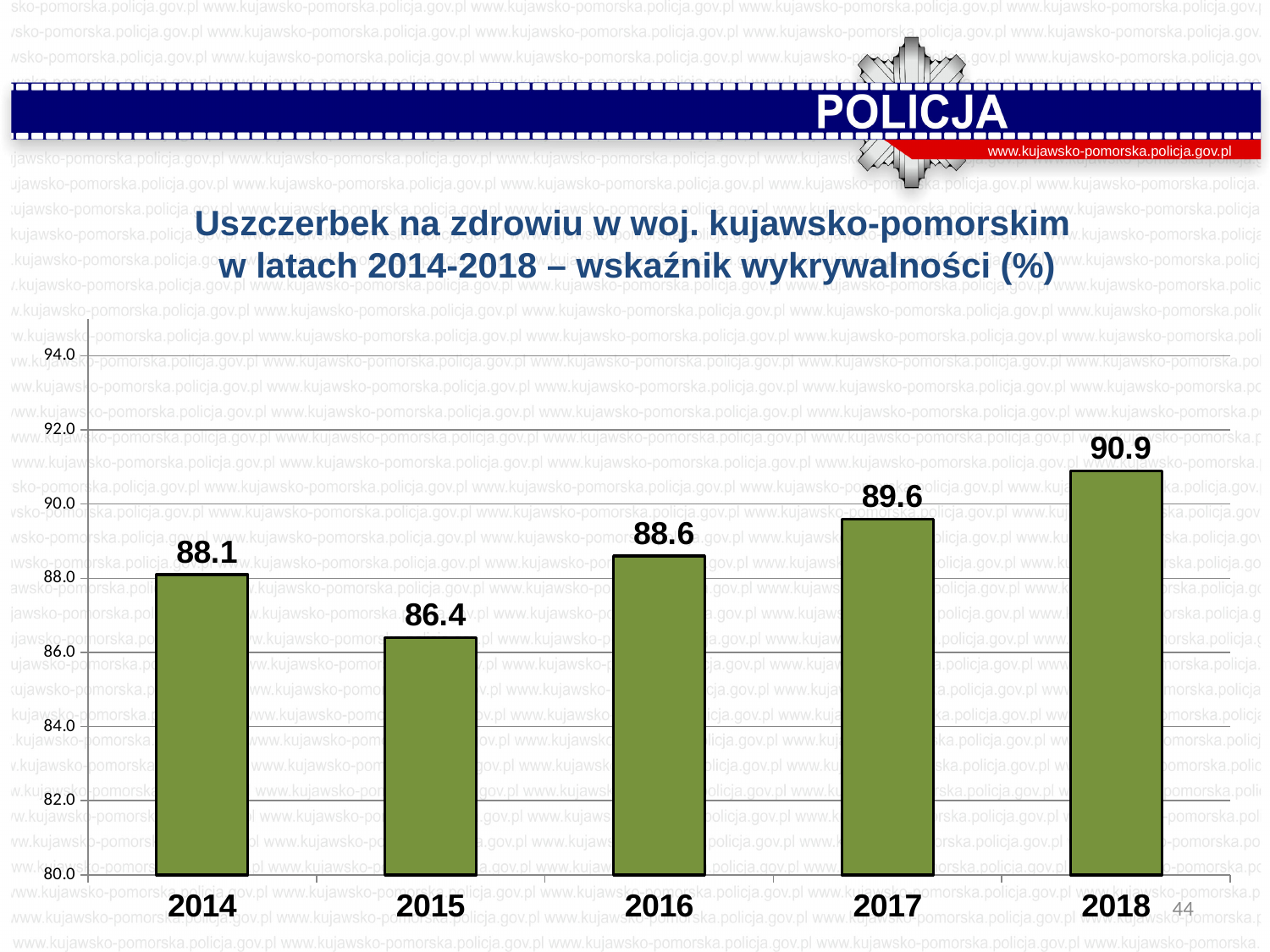
Which is larger, the value for 2014 or the value for 2015? 2014 How many years are shown on the x axis? 5 What is the difference between the values for 2017 and 2016? 1.0 What is the detection rate value for 2018? 90.9 What kind of chart is shown on the slide? bar chart Do the values rise or fall from 2015 to 2018? rise What is the difference between the values for 2018 and 2014? 2.8 What is the value shown for 2016? 88.6 Is the value for 2017 greater or less than 90.0? less Which year has the lowest value? 2015 Which year has the highest value? 2018 What is the value shown for 2015? 86.4